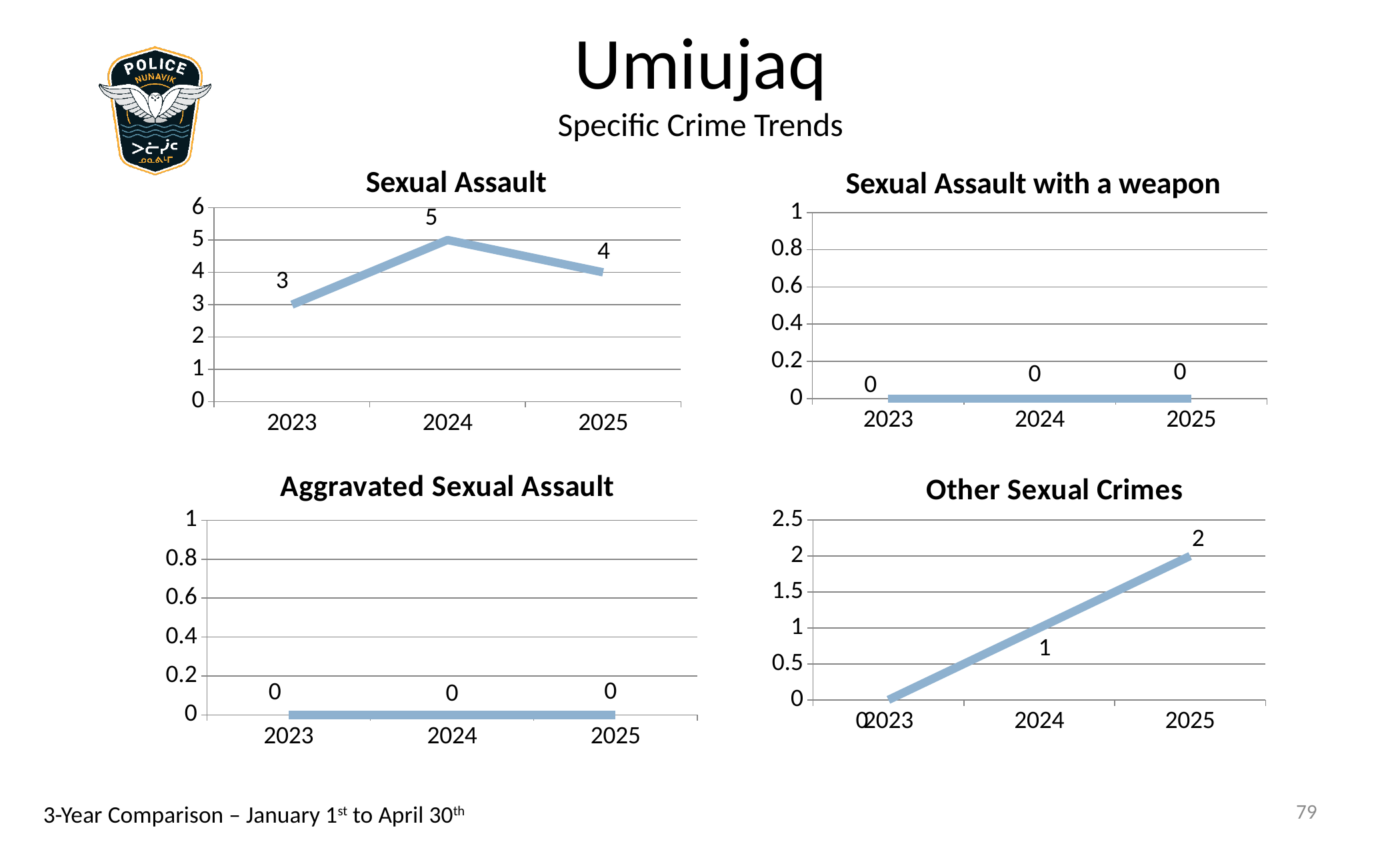
In the Sexual Assault chart, which year has the lowest value? 2023 How many charts are shown on the slide? 4 In the Aggravated Sexual Assault chart, how many years are plotted? 3 In the Sexual Assault chart, is the value for 2025 larger or smaller than the value for 2023? larger In the Other Sexual Crimes chart, what is the value for 2024? 1 In the Other Sexual Crimes chart, do the values rise or fall from 2023 to 2025? rise What kind of chart is the Other Sexual Crimes chart? line chart In the Sexual Assault chart, which year has the highest value? 2024 In the Sexual Assault chart, what is the value for 2024? 5 In the Sexual Assault chart, what is the difference between the 2024 and 2023 values? 2 In the Other Sexual Crimes chart, what is the value for 2025? 2 In the Sexual Assault with a weapon chart, what is the value for 2025? 0